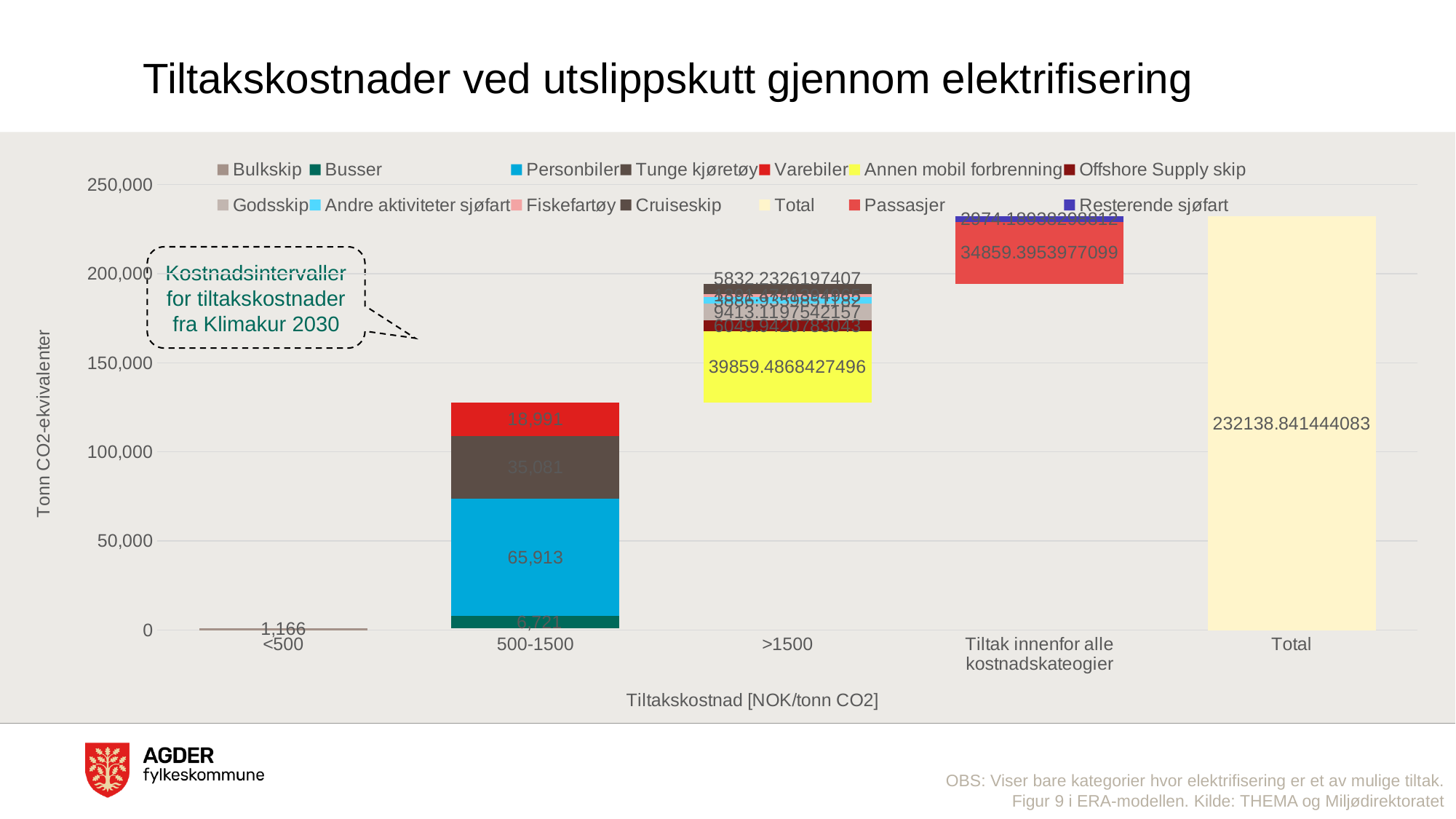
What is the value for Tunge kjøretøy in the 500-1500 category? 35,081 What is the value shown for the Total bar? 232138.841444083 What kind of chart is shown on the slide? Stacked bar chart What is the value for Busser in the 500-1500 category? 6,721 What is the value for Annen mobil forbrenning in the >1500 category? 39859.4868427496 How many series does the chart legend list? 14 How many categories are shown on the x axis of the chart? 5 What is the difference between the Personbiler and Tunge kjøretøy values in the 500-1500 category? 30,832 What is the value for Passasjer in the 'Tiltak innenfor alle kostnadskateogier' category? 34859.3953977099 What is the value for Personbiler in the 500-1500 category? 65,913 What is the value for Varebiler in the 500-1500 category? 18,991